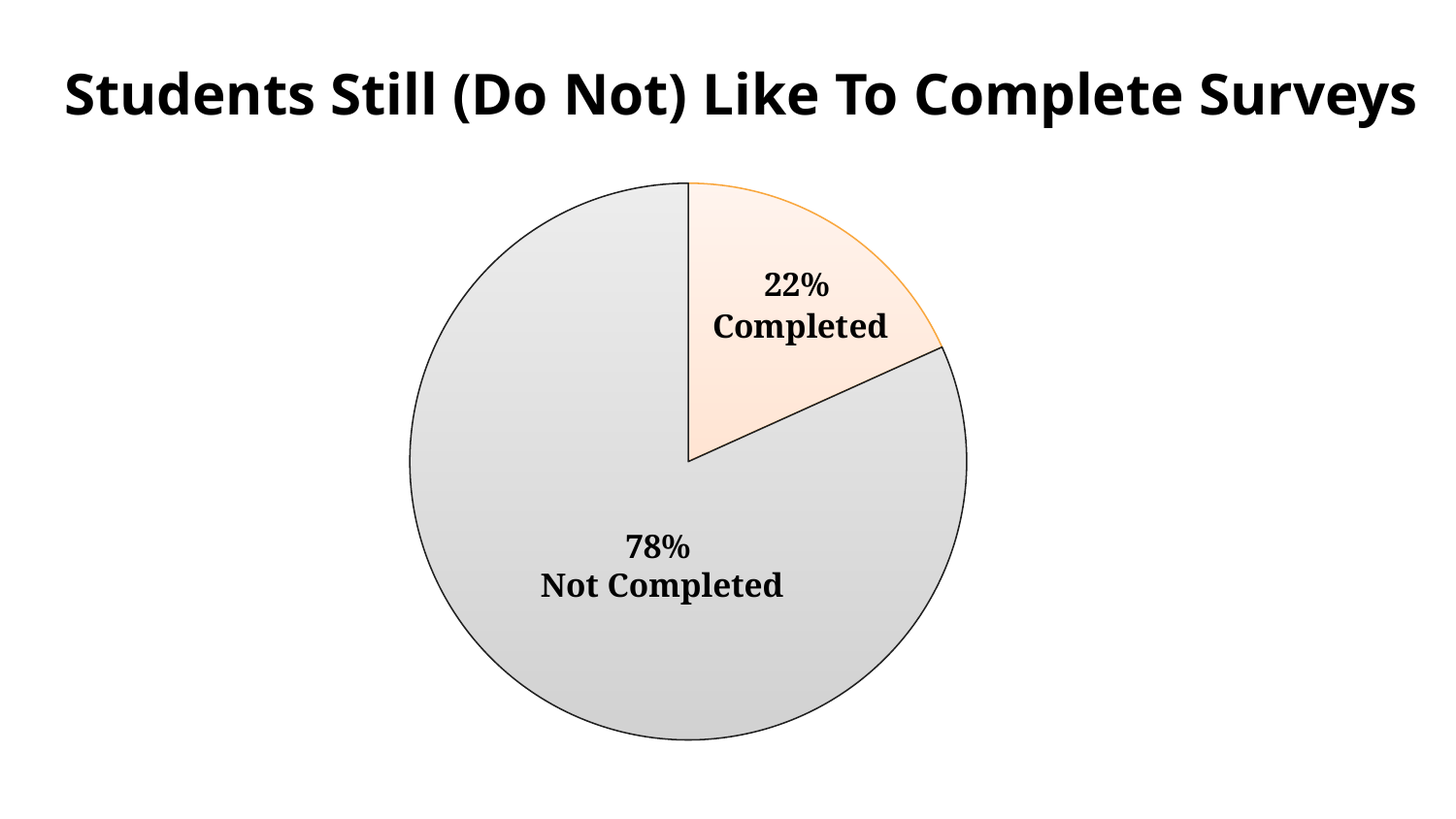
Which slice of the pie is the largest? Not Completed What share of the pie does the Completed slice represent? 22% How many slices does the pie chart have? 2 What kind of chart is shown on the slide? Pie chart Which slice is shaded orange? Completed What is the difference in percentage points between the Not Completed and Completed slices? 56 Do the two slices add up to 100%? Yes What percentage of students completed the survey? 22% Which is larger, the Completed slice or the Not Completed slice? Not Completed What percentage of students did not complete the survey? 78% What is the title of the slide? Students Still (Do Not) Like To Complete Surveys Which slice of the pie is the smallest? Completed